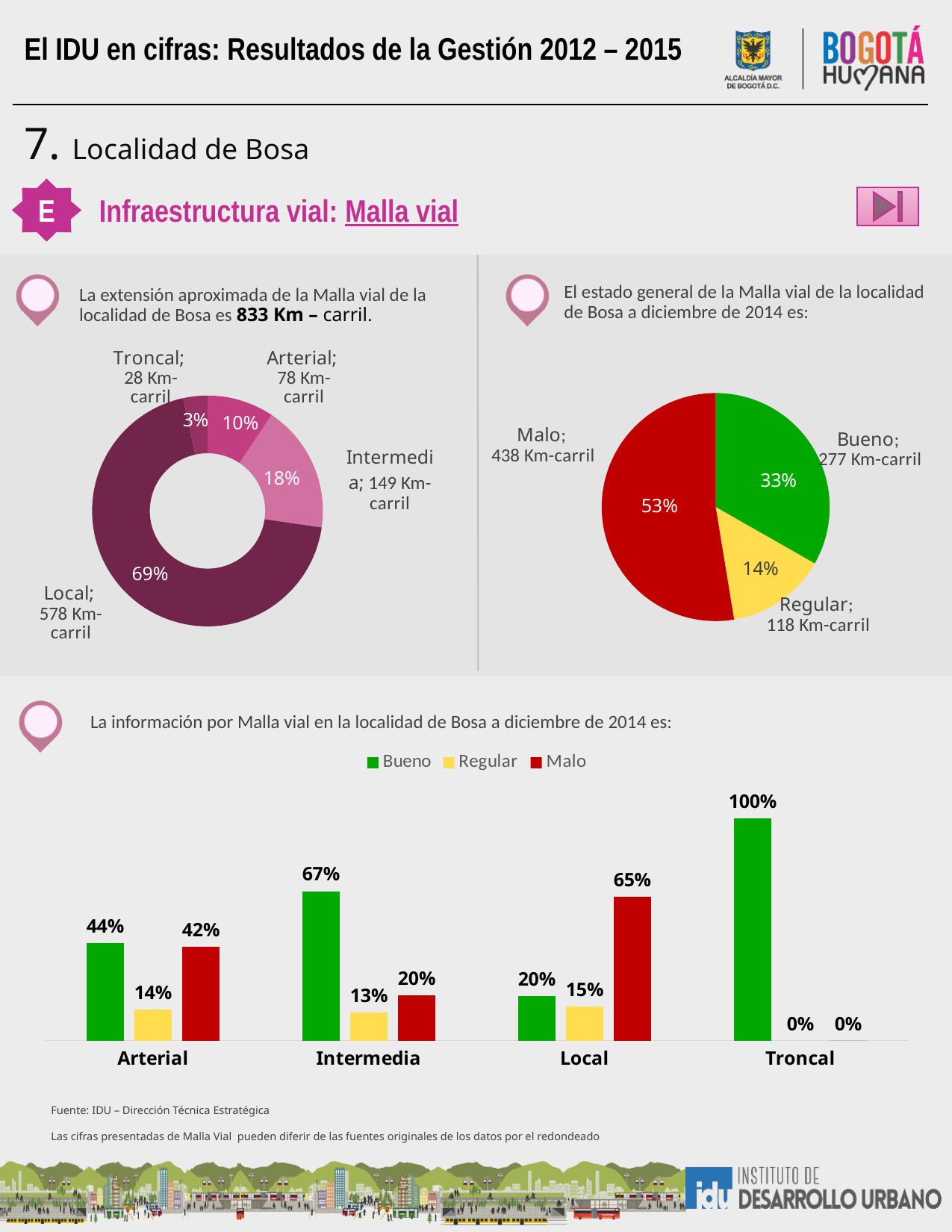
What type of chart is the bottom chart? Bar chart In the bottom bar chart, how many series does the legend list? 3 In the top-right pie chart, what is the difference in Km-carril between Malo and Regular? 320 Km-carril In the top-right pie chart, how many Km-carril are in Bueno condition? 277 Km-carril In the bottom bar chart, which is larger for Arterial: Bueno or Malo? Bueno In the top-left donut chart, how many categories are shown? 4 In the top-left donut chart, what share of the road network is Local? 69% In the bottom bar chart, what is the Bueno value for Intermedia? 67% In the top-right pie chart, what share of the road network is in Malo condition? 53% In the bottom bar chart, which road type has the highest Malo value? Local In the top-left donut chart, which category has the smallest share? Troncal In the top-left donut chart, how many Km-carril does the Intermedia category have? 149 Km-carril